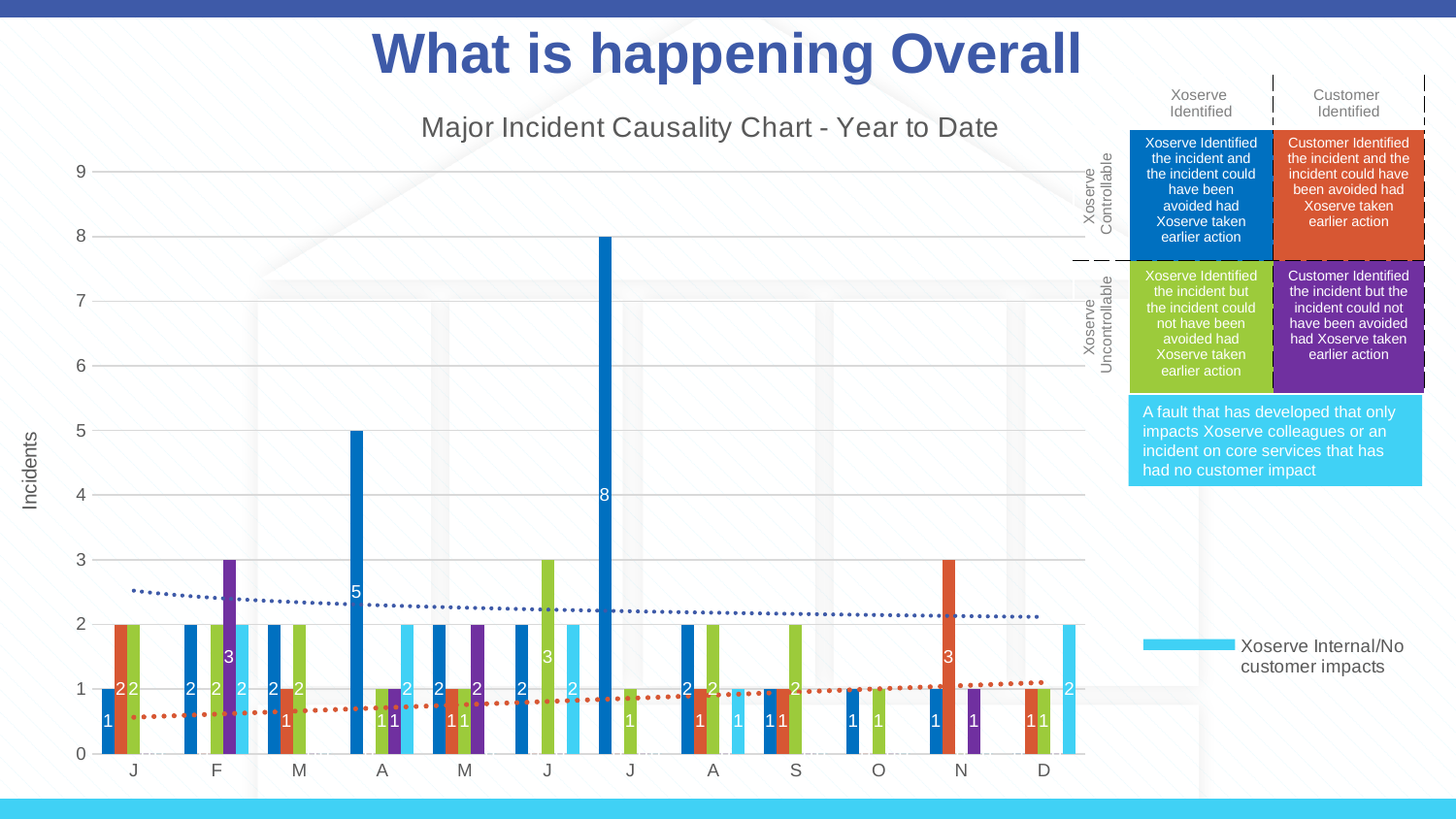
In which month does the tallest bar (value 8) occur? July (the second J) What is the value of the dark blue bar in April (A)? 5 What is the value of the green bar in June (the first J after M)? 3 How many months are shown along the x axis of the chart? 12 What is the label of the y axis? Incidents Which is larger: the dark blue bar in April or the purple bar in February? The dark blue bar in April What type of chart is the Major Incident Causality Chart? Bar chart What is the highest value labelled on any bar in the chart? 8 What is the difference between the dark blue bar in July (8) and the dark blue bar in April (5)? 3 What is the value of the purple bar in February (F)? 3 What is the value of the orange bar in November (N)? 3 What is the title of the chart on the slide? Major Incident Causality Chart - Year to Date